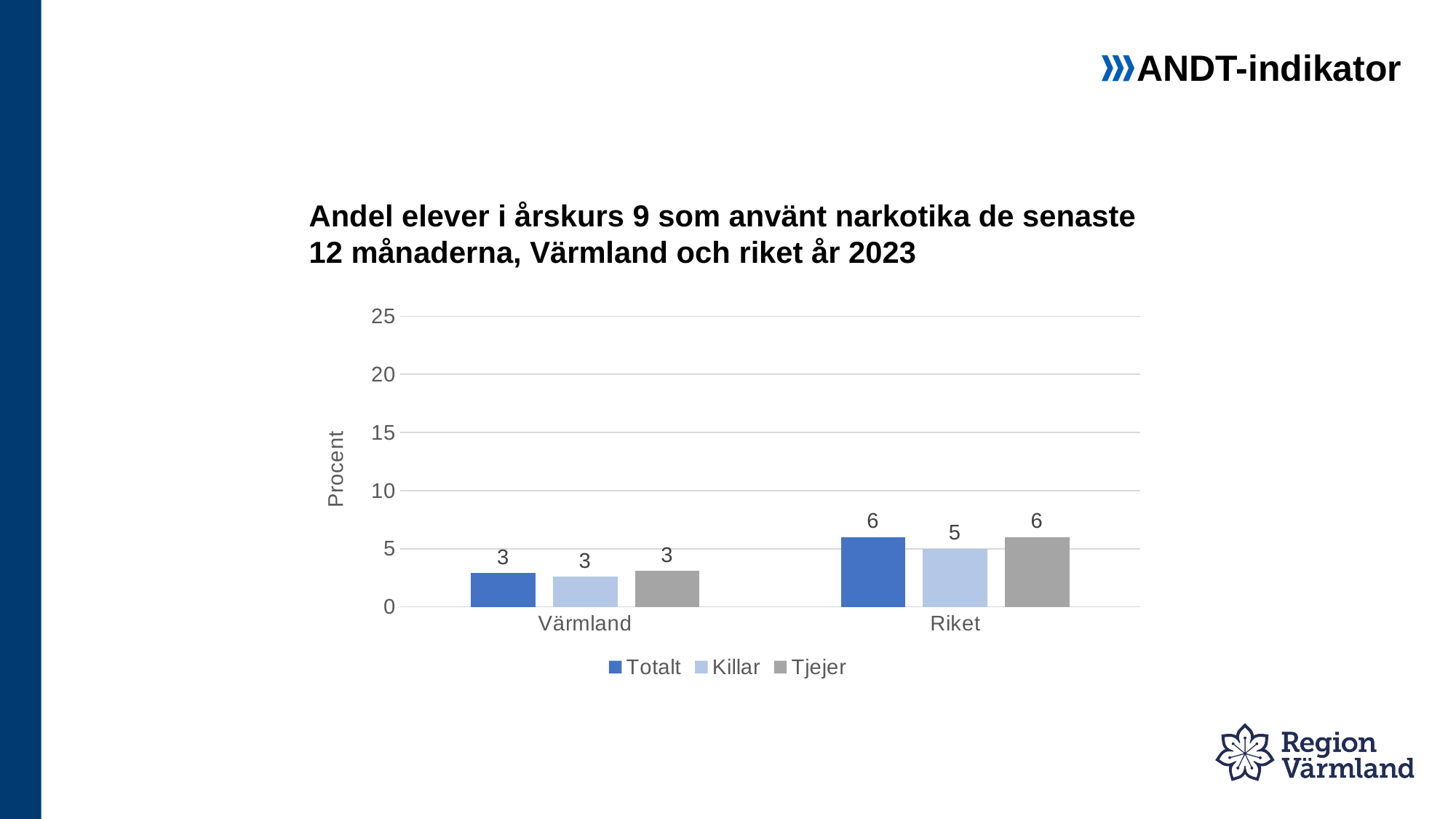
What is the value for Totalt in Värmland? 3 What is the difference between the Totalt value for Riket and the Totalt value for Värmland? 3 What kind of chart is shown on the slide? bar chart What is the label of the y axis? Procent How many categories are shown on the x axis? 2 Which series has the lowest value in Riket? Killar Is the Totalt value for Riket greater or less than 10? less What is the value for Tjejer in Riket? 6 How many series does the legend list? 3 What is the value for Tjejer in Värmland? 3 Which is larger, the Killar value for Riket or the Killar value for Värmland? Riket What is the value for Killar in Riket? 5